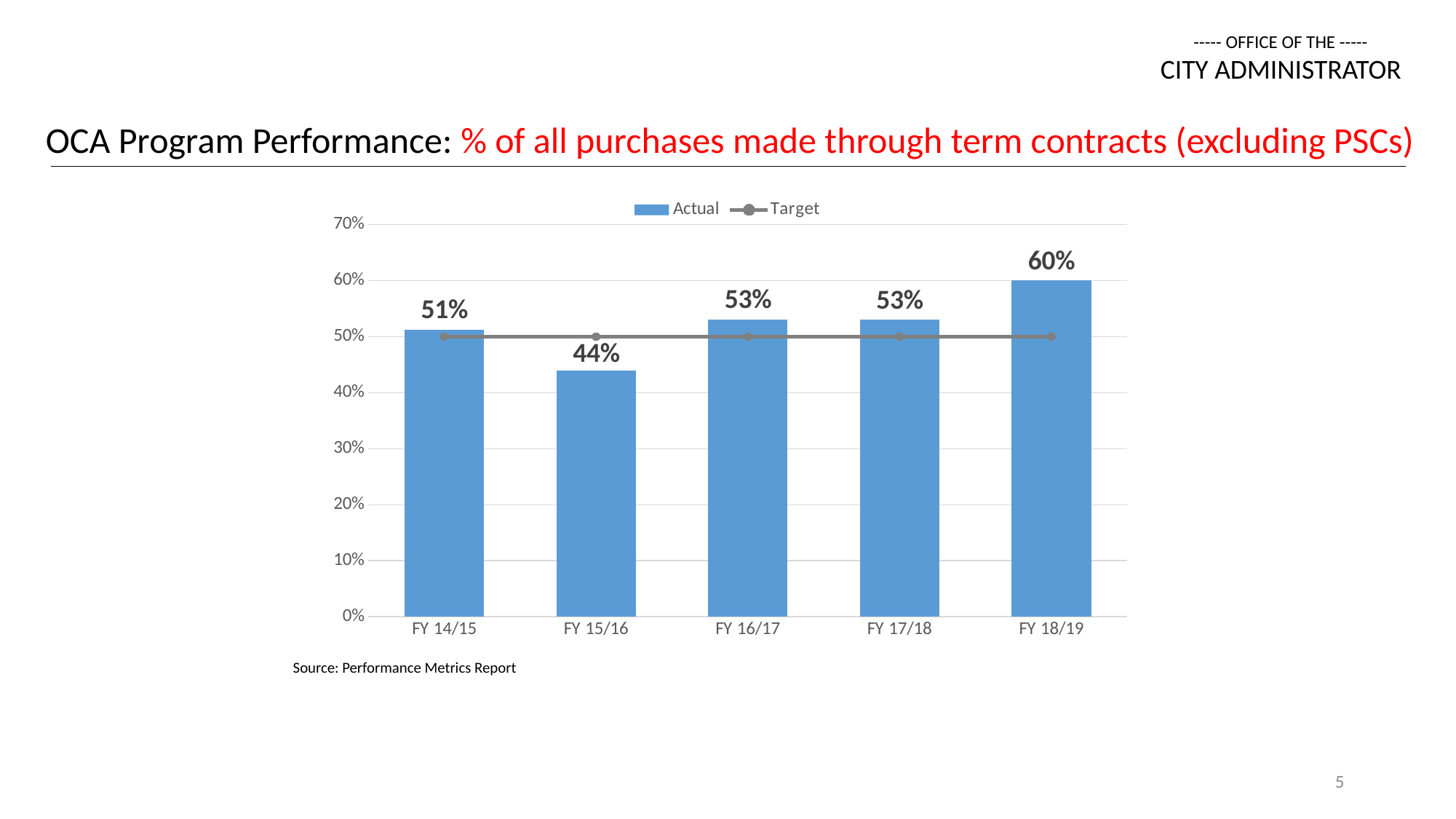
What is the Actual value for FY 14/15? 51% What is the Actual value for FY 15/16? 44% What kind of chart is used to show the Actual values? Bar chart How many series does the legend list? 2 Which fiscal year has the highest Actual value? FY 18/19 What are the two series named in the legend? Actual and Target How many fiscal years are shown on the x axis? 5 What is the difference between the Actual values for FY 18/19 and FY 15/16? 16% Which fiscal year has the lowest Actual value? FY 15/16 Is the Target value for FY 15/16 greater or less than 40%? greater What is the Actual value for FY 18/19? 60% Which is larger, the Actual value for FY 14/15 or for FY 16/17? FY 16/17